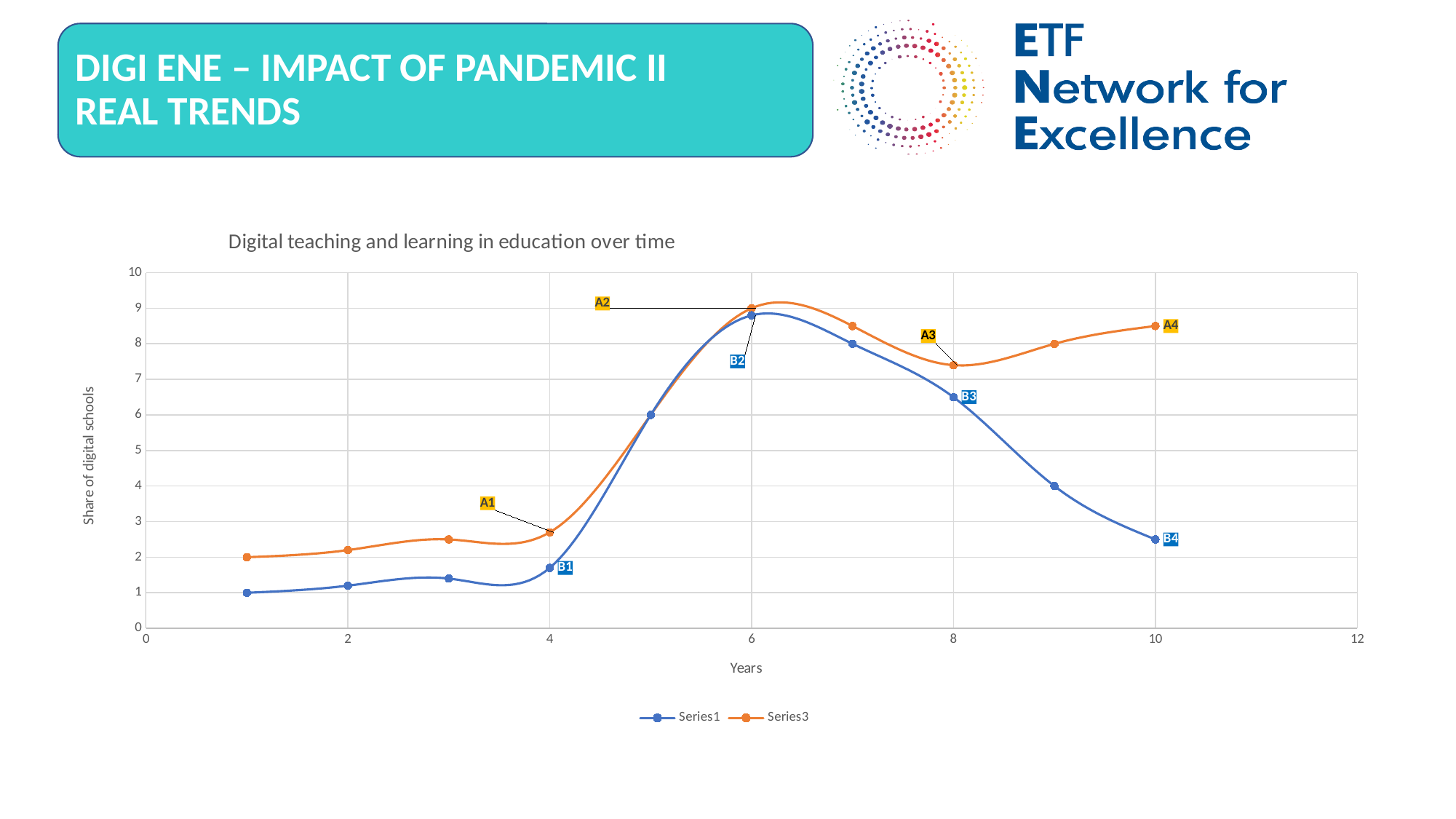
How many data points does Series1 have? 10 What is the value of Series1 at year 9? 4 What kind of chart is shown on the slide? line chart What is the value of Series1 at year 5? 6 At year 10, which series has the higher value, Series1 or Series3? Series3 Does Series1 rise or fall between year 6 and year 10? fall How many series does the legend list? 2 What is the label of the vertical axis? Share of digital schools What is the title of the chart? Digital teaching and learning in education over time What is the value of Series3 at year 1? 2 Is the value for Series1 at year 10 greater or less than 3? less What is the difference between the Series1 values at year 5 and year 9? 2